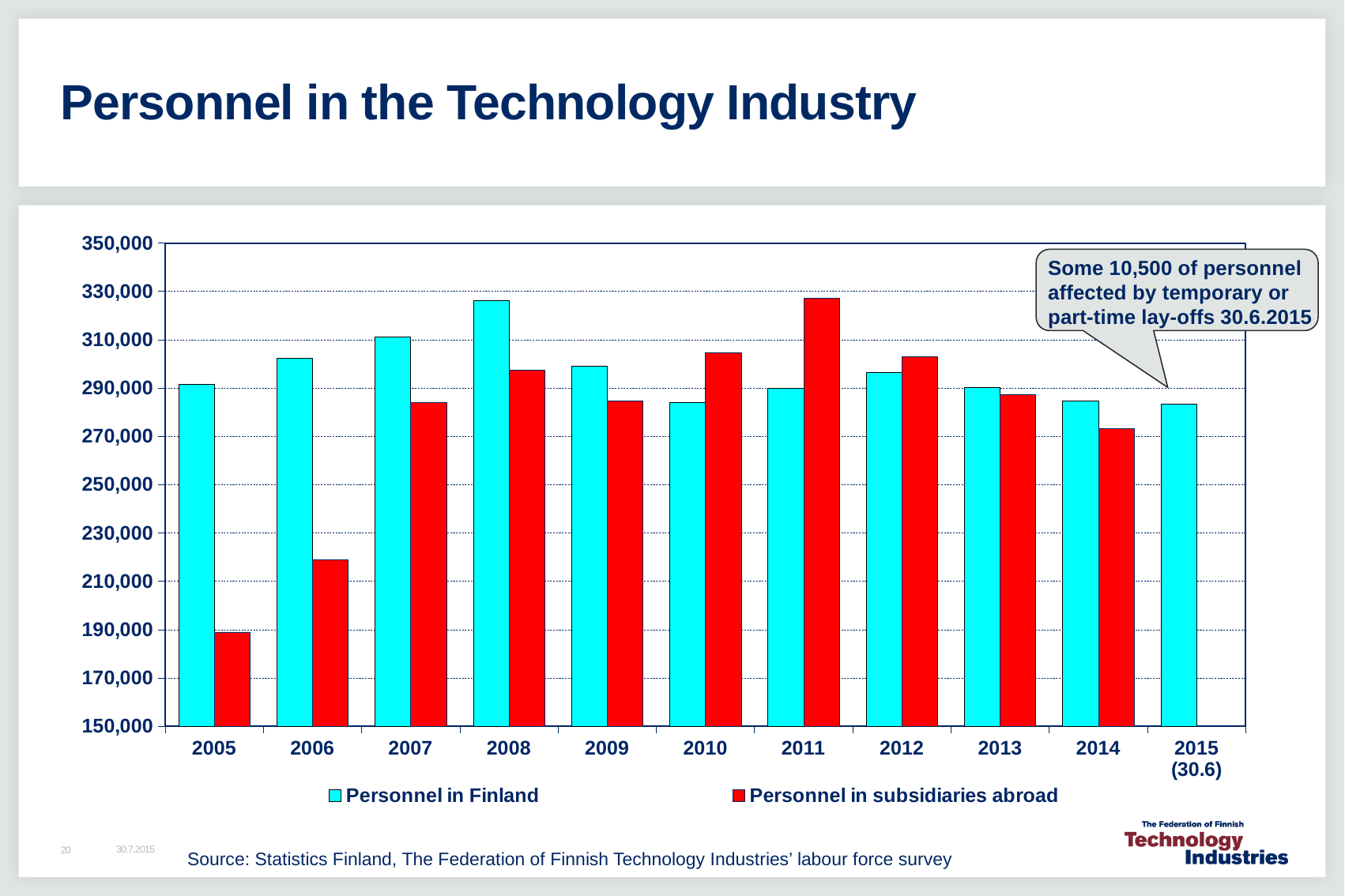
In 2011, which is larger: Personnel in Finland or Personnel in subsidiaries abroad? Personnel in subsidiaries abroad In which year is Personnel in subsidiaries abroad lowest? 2005 In which year is Personnel in Finland highest? 2008 Does Personnel in subsidiaries abroad rise or fall from 2005 to 2008? Rise How many series does the legend list? 2 What kind of chart is shown on the slide? Bar chart In which year is Personnel in subsidiaries abroad highest? 2011 Is the value for Personnel in Finland in 2008 greater or less than 310,000? greater In 2005, which is larger: Personnel in Finland or Personnel in subsidiaries abroad? Personnel in Finland Is the value for Personnel in subsidiaries abroad in 2014 greater or less than 290,000? less Is the value for Personnel in subsidiaries abroad in 2005 greater or less than 210,000? less How many years (categories) are shown on the x axis? 11